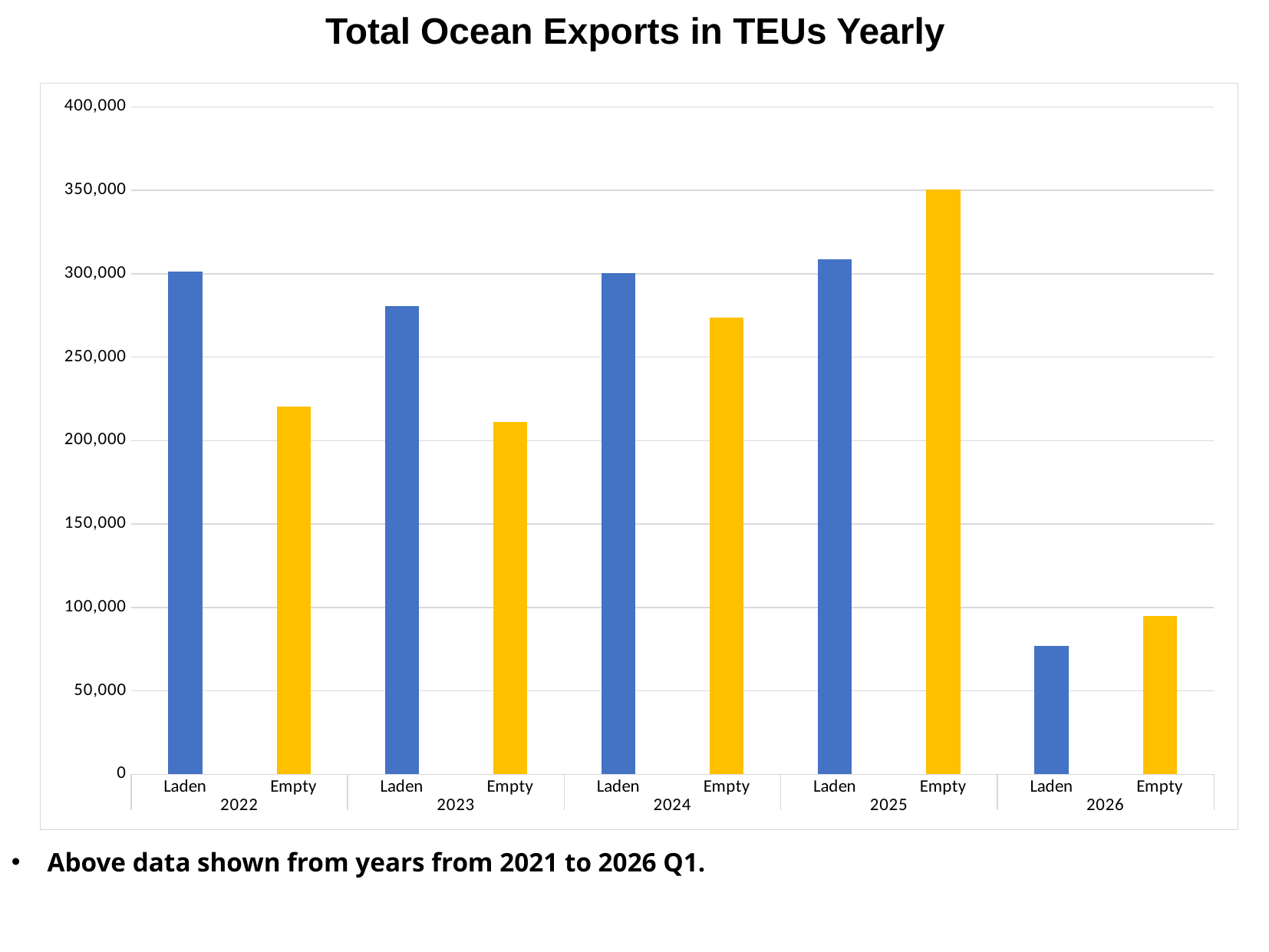
Is the value for Empty in 2022 greater or less than 200,000? greater How many bars are plotted in the chart? 10 Is the value for Laden in 2026 greater or less than 100,000? less In 2025, which is larger, Laden or Empty? Empty Is the value for Empty in 2024 greater or less than 250,000? greater Which bar is the lowest in the chart? Laden 2026 What is the title of the chart? Total Ocean Exports in TEUs Yearly How many year groups are shown on the x axis? 5 What kind of chart is shown on the slide? Bar chart Which bar is the highest in the chart? Empty 2025 In 2022, which is larger, Laden or Empty? Laden